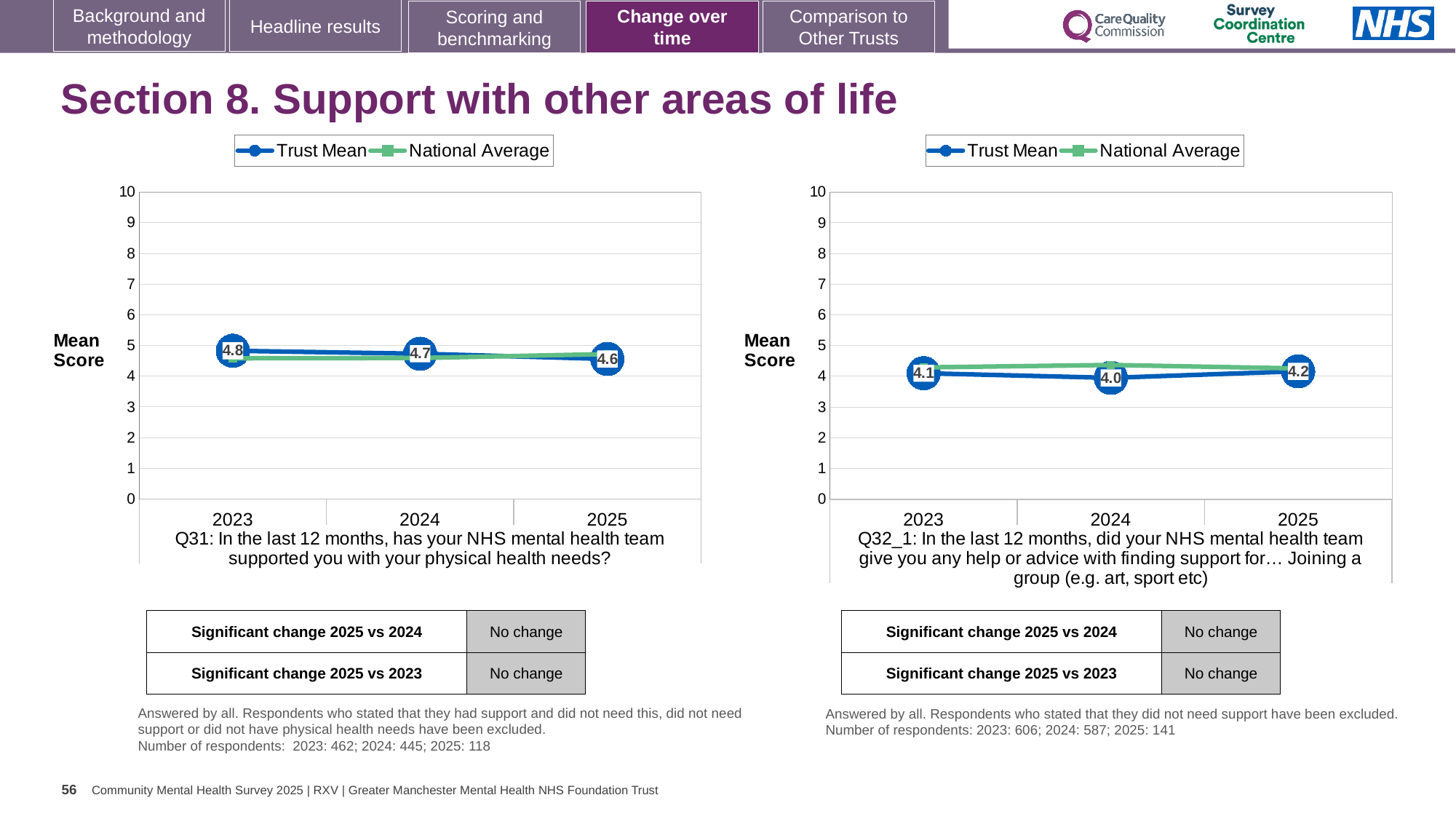
In the Q31 chart on the left, which year has the highest Trust Mean? 2023 In the Q32_1 chart on the right, which year has the lowest Trust Mean? 2024 In the Q31 chart on the left, what is the Trust Mean for 2025? 4.6 In the Q31 chart on the left, is the National Average for 2023 greater or less than 5? less In the Q31 chart on the left, what is the difference between the Trust Mean for 2023 and 2025? 0.2 In the Q32_1 chart on the right, is the Trust Mean higher in 2023 or 2025? 2025 In the Q31 chart on the left, does the Trust Mean rise or fall from 2023 to 2025? fall In the Q32_1 chart on the right, what is the Trust Mean for 2025? 4.2 In the Q32_1 chart on the right, what is the Trust Mean for 2024? 4.0 What kind of chart is the Q31 chart on the left? line chart How many series does the legend of the Q32_1 chart on the right list? 2 In the Q31 chart on the left, what is the Trust Mean for 2023? 4.8